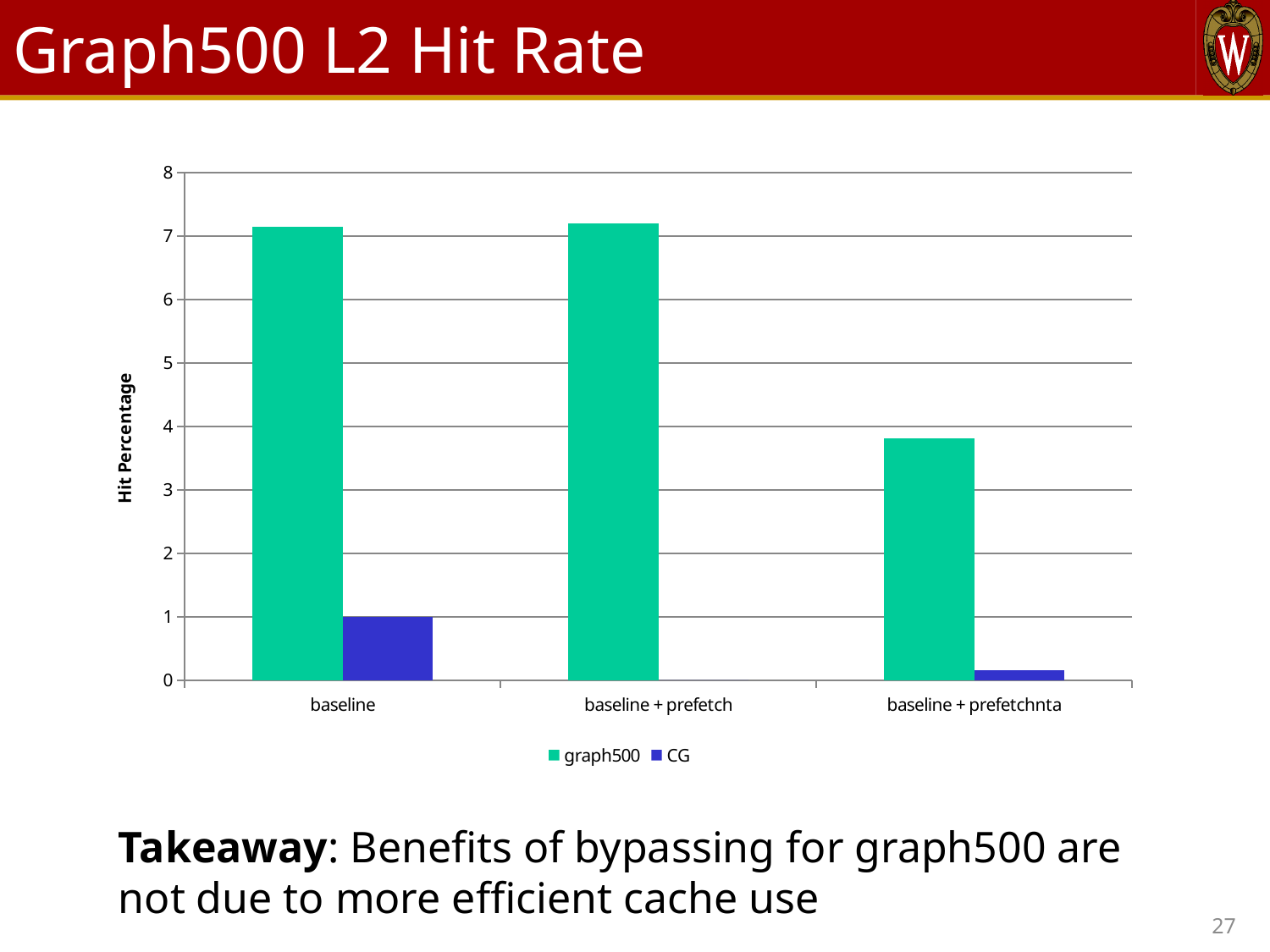
Which category has the lowest value for the graph500 series? baseline + prefetchnta How many series does the legend list? 2 In the baseline category, which series has the larger value, graph500 or CG? graph500 Which is larger, the graph500 value for baseline or for baseline + prefetchnta? baseline Is the graph500 value for baseline + prefetchnta greater or less than 4? less Which category has the highest value for the CG series? baseline What is the title of the chart on the slide? Graph500 L2 Hit Rate Is the graph500 value for baseline greater or less than 7? greater What is the label on the y axis? Hit Percentage Is the CG value for baseline + prefetchnta greater or less than 1? less How many categories are shown on the x axis? 3 What kind of chart is shown on the slide? bar chart